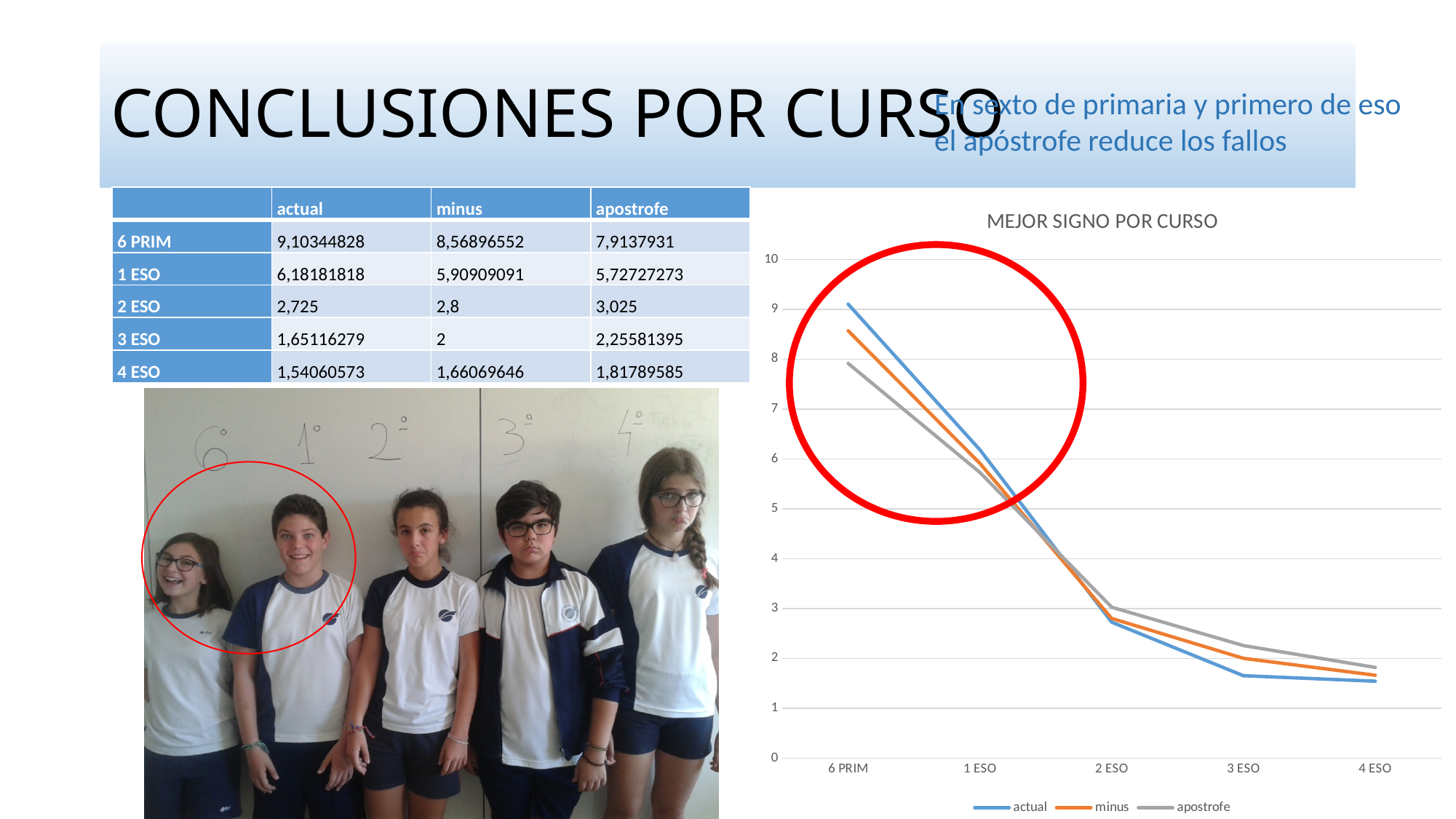
At 6 PRIM, which series has the larger value, 'actual' or 'apostrofe'? actual How many series does the legend of the 'MEJOR SIGNO POR CURSO' chart list? 3 How many categories are shown on the x axis of the 'MEJOR SIGNO POR CURSO' chart? 5 At 3 ESO, which series has the larger value, 'actual' or 'apostrofe'? apostrofe What kind of chart is 'MEJOR SIGNO POR CURSO'? line chart Is the value for 'apostrofe' at 1 ESO greater or less than 6? less Is the value for 'actual' at 6 PRIM greater or less than 8? greater Which category has the highest value for the 'actual' series? 6 PRIM Do the values of the 'actual' series rise or fall from 6 PRIM to 4 ESO? fall According to the table, what is the value of 'actual' for 6 PRIM? 9,10344828 What is the title of the line chart on the slide? MEJOR SIGNO POR CURSO Which category has the lowest value for the 'apostrofe' series? 4 ESO